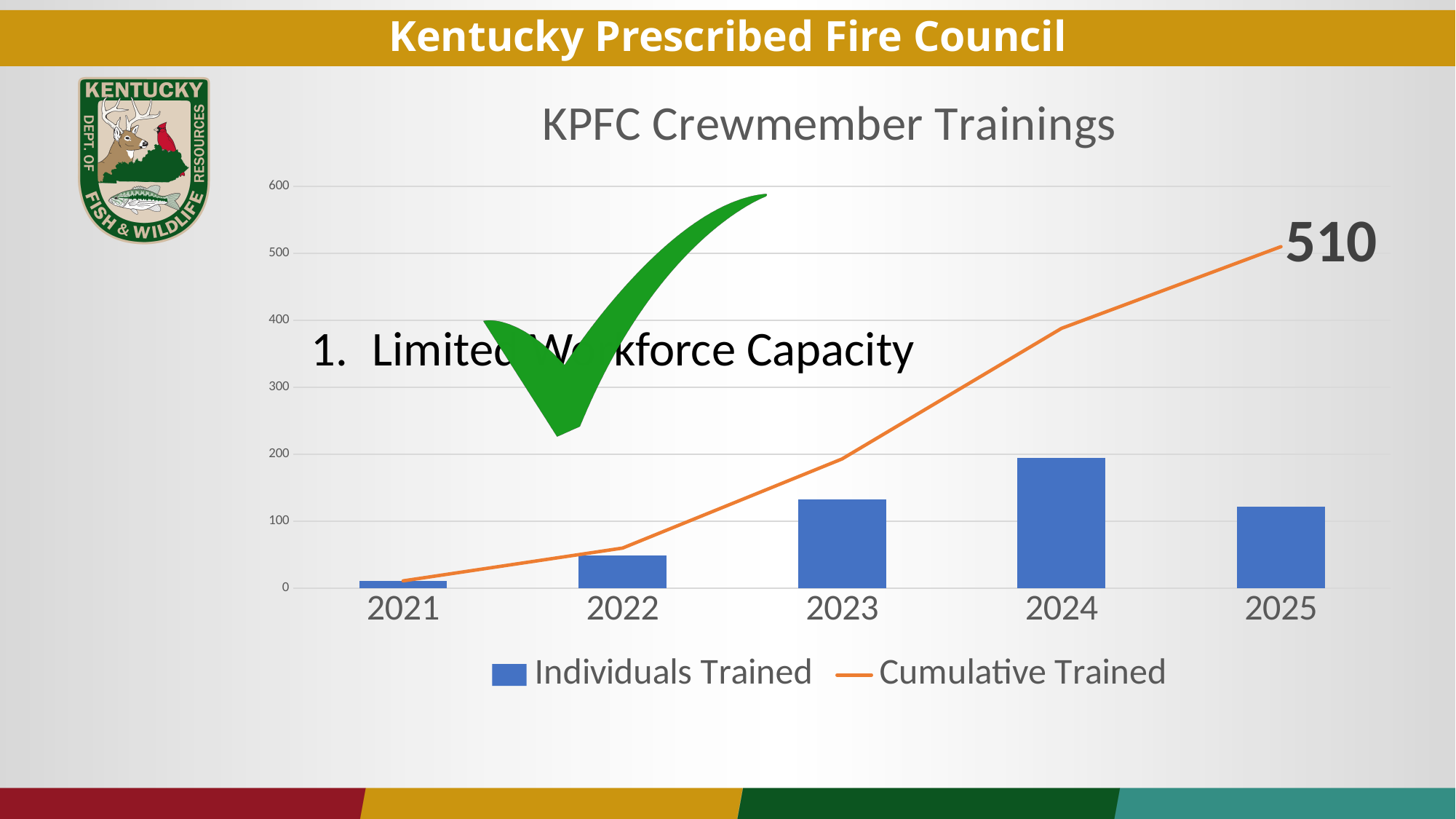
Which year had more individuals trained, 2022 or 2024? 2024 How many series does the legend list? 2 Is the number of individuals trained in 2023 greater or less than 100? greater What is the title of the chart? KPFC Crewmember Trainings Which year has the highest number of individuals trained? 2024 Which year has the lowest number of individuals trained? 2021 How many years are shown on the x axis? 5 Does the Cumulative Trained line rise or fall from 2021 to 2025? rise What is the cumulative number trained shown for 2025? 510 Is the number of individuals trained in 2022 greater or less than 100? less Is the number of individuals trained in 2024 greater or less than 150? greater